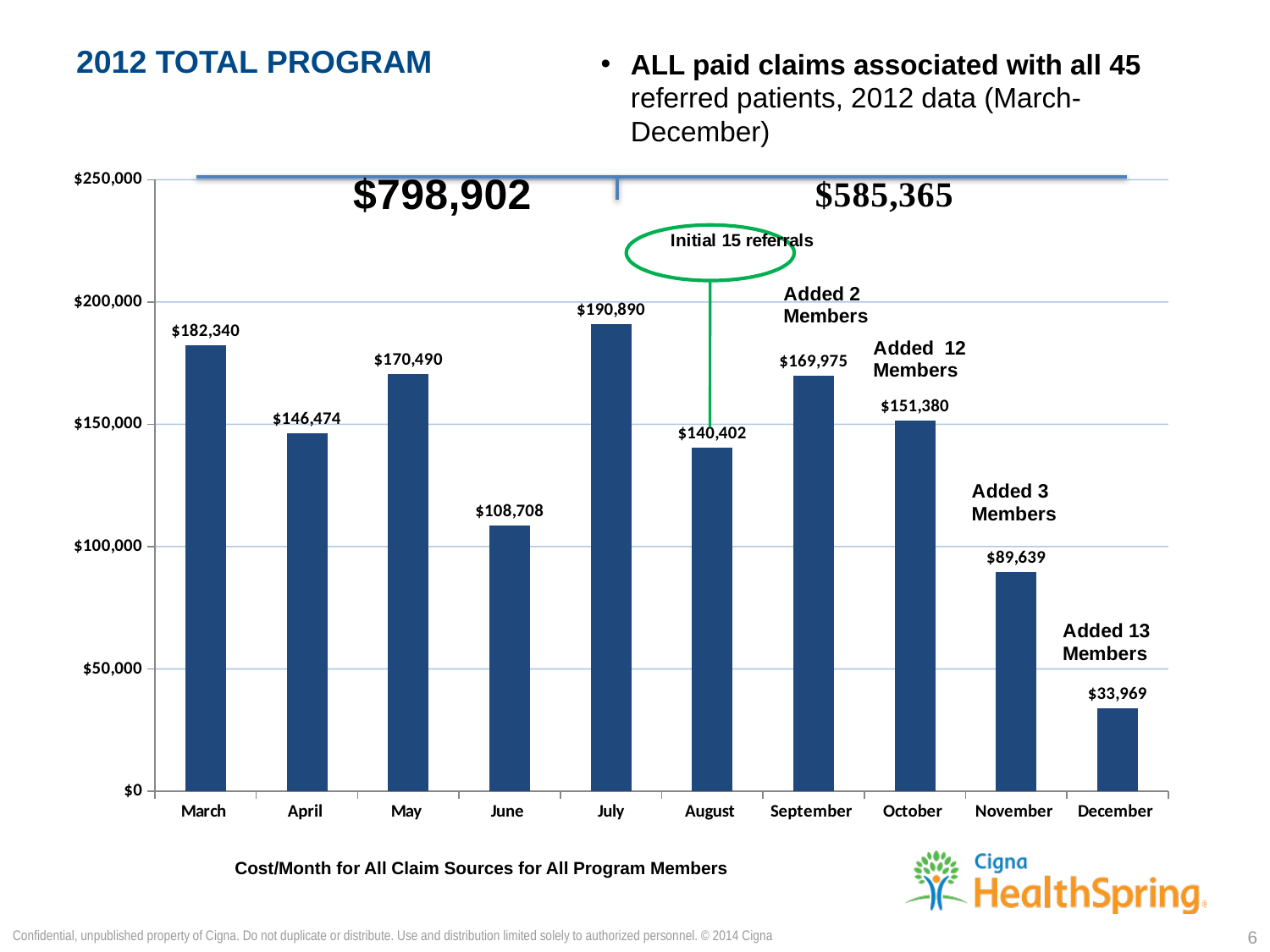
Is the value for November greater or less than $100,000? less Which is larger, the value for March or the value for May? March What is the difference between the values for July and August? $50,488 Do the values rise or fall from September to December? fall What is the value for July? $190,890 What is the value for December? $33,969 How many months are shown on the x axis? 10 What is the difference between the values for November and December? $55,670 Which month has the highest value? July What is the value for June? $108,708 What kind of chart is shown on the slide? bar chart Which month has the lowest value? December